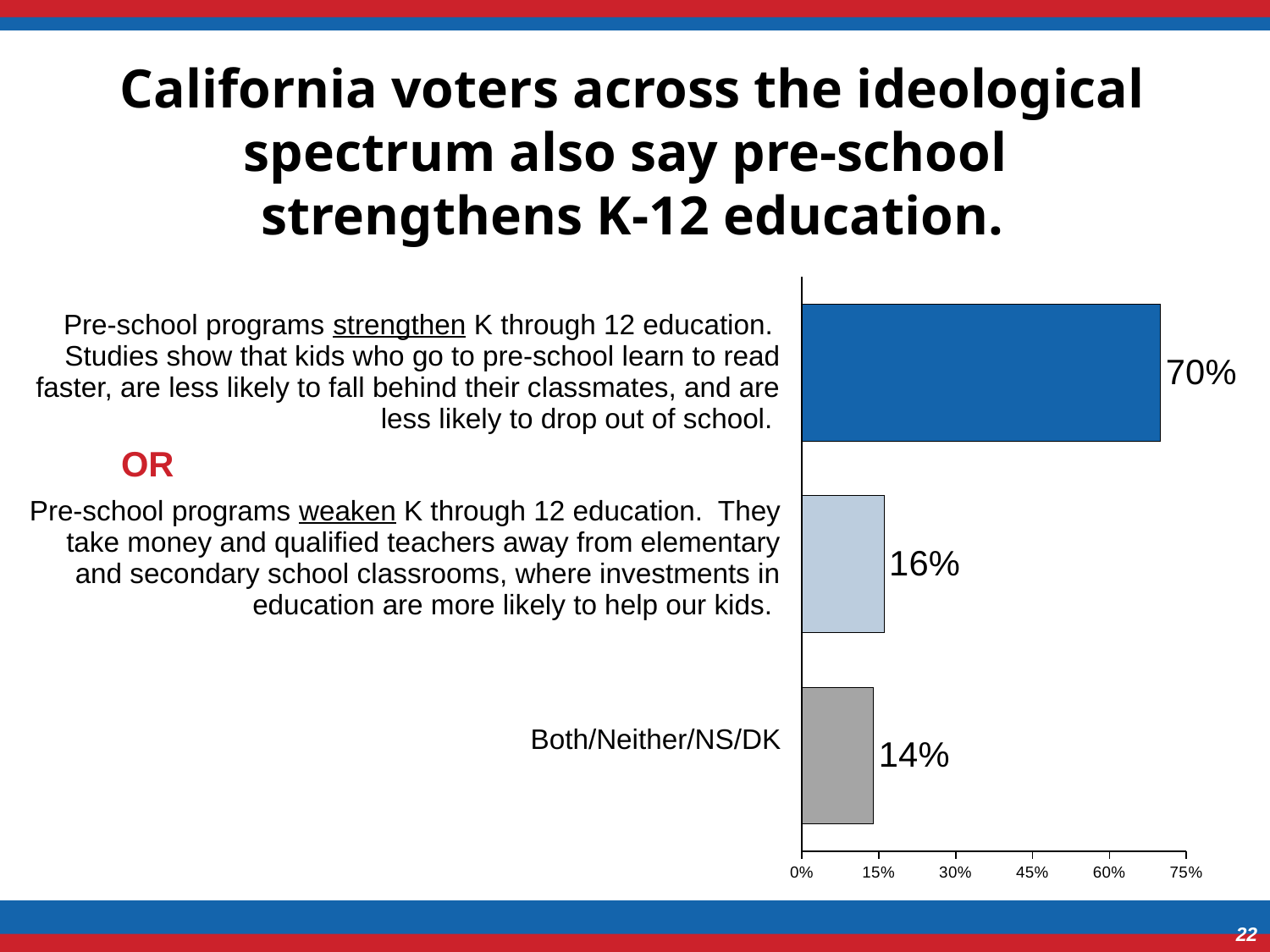
What type of chart is shown on the slide? Bar chart Which is larger: the share saying pre-school weakens K-12 education or the Both/Neither/NS/DK share? Pre-school programs weaken K through 12 education What is the maximum value shown on the horizontal axis? 75% Which response option has the highest percentage? Pre-school programs strengthen K through 12 education What percentage of voters say pre-school programs strengthen K through 12 education? 70% How many bars are shown in the chart? 3 What is the value for the Both/Neither/NS/DK category? 14% Is the value for the 'strengthen' response greater or less than 60%? greater Which response option has the lowest percentage? Both/Neither/NS/DK What is the difference in percentage points between those who say pre-school strengthens K-12 education and those who say it weakens it? 54 What percentage of voters say pre-school programs weaken K through 12 education? 16% What colour is the bar for the 'strengthen' response? Dark blue